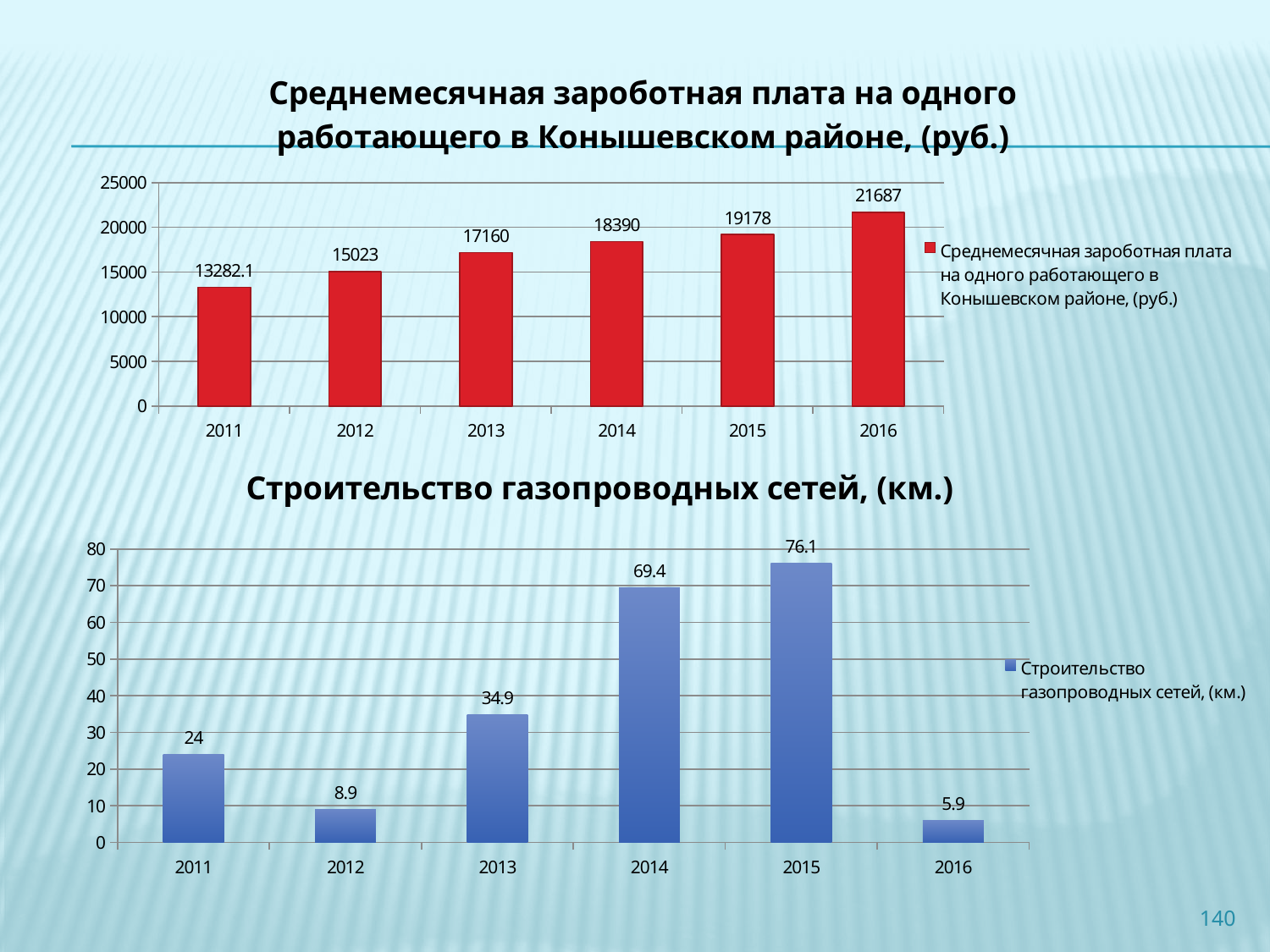
In the bottom chart (Строительство газопроводных сетей), what is the difference between the values for 2015 and 2014? 6.7 In the bottom chart (Строительство газопроводных сетей), which year has the lowest value? 2016 What kind of chart is the bottom chart (Строительство газопроводных сетей)? bar chart In the top chart (Среднемесячная заработная плата), do the values rise or fall from 2011 to 2016? rise In the bottom chart (Строительство газопроводных сетей), what is the value for 2014? 69.4 In the top chart (Среднемесячная заработная плата), what is the value for 2013? 17160 In the top chart (Среднемесячная заработная плата), which year has the highest value? 2016 In the bottom chart (Строительство газопроводных сетей), which year has the highest value? 2015 In the top chart (Среднемесячная заработная плата), what is the difference between the values for 2016 and 2015? 2509 In the bottom chart (Строительство газопроводных сетей), which is larger, the value for 2011 or the value for 2012? 2011 In the top chart (Среднемесячная заработная плата), how many years are shown on the x axis? 6 In the top chart (Среднемесячная заработная плата), what is the value for 2011? 13282.1